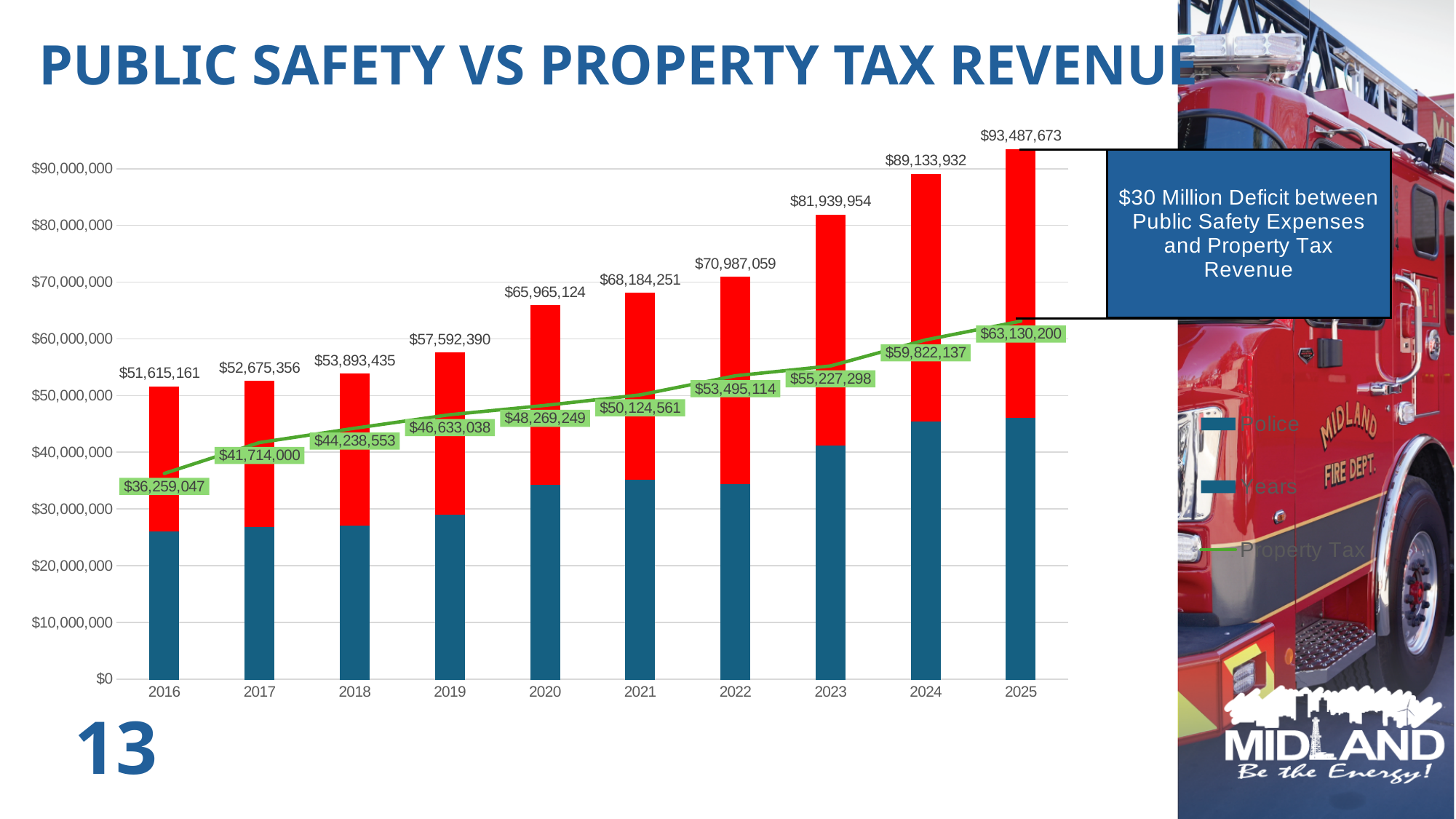
What is the difference between the 2025 total bar value and the 2025 Property Tax value? $30,357,473 What is the Property Tax value for 2016? $36,259,047 How many years are shown on the x axis? 10 What is the difference between the total bar values for 2024 and 2023? $7,193,978 What is the total stacked bar value for 2025? $93,487,673 What is the Property Tax value for 2022? $53,495,114 Which year has the highest total stacked bar value? 2025 How many series does the legend list? 3 Is the blue (bottom) segment of the 2016 bar greater or less than $30,000,000? less Which is larger, the total bar value for 2020 or the total bar value for 2019? 2020 Does the Property Tax line rise or fall from 2016 to 2025? rise Which year has the lowest Property Tax value? 2016